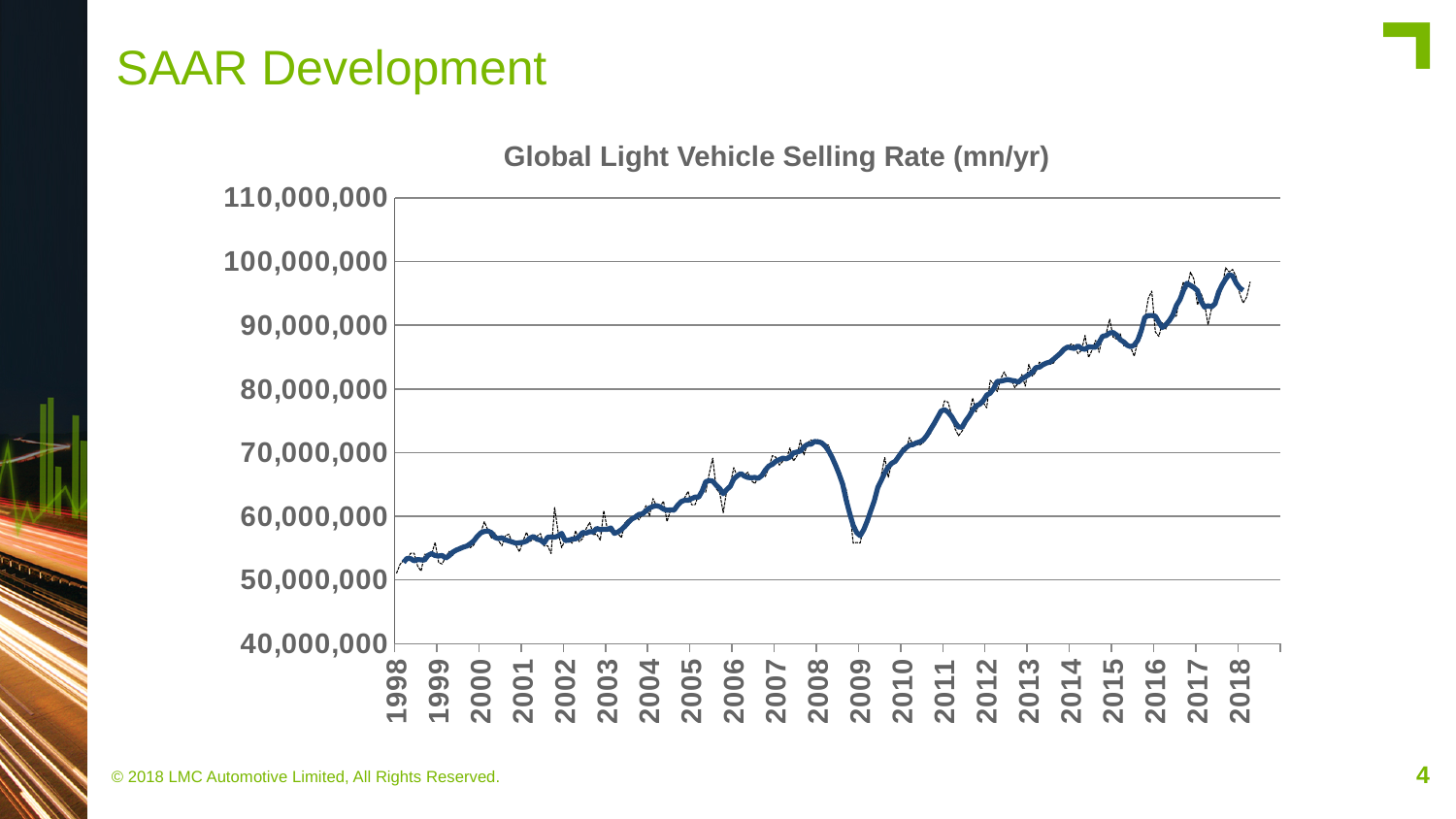
Which is larger, the value at the start of 2010 or the value at the start of 2005? 2010 What kind of chart is shown on the slide? line chart Is the value at the 2009 trough greater or less than 60,000,000? less Is the value at the start of 2000 greater or less than 60,000,000? less Is the value at the start of 2014 greater or less than 80,000,000? greater What is the highest value labelled on the y axis? 110,000,000 What is the title of the chart? Global Light Vehicle Selling Rate (mn/yr) How many year labels are shown on the x axis? 21 Overall, do the values rise or fall from 1998 to 2018? rise In which year does the line reach its lowest point? 1998